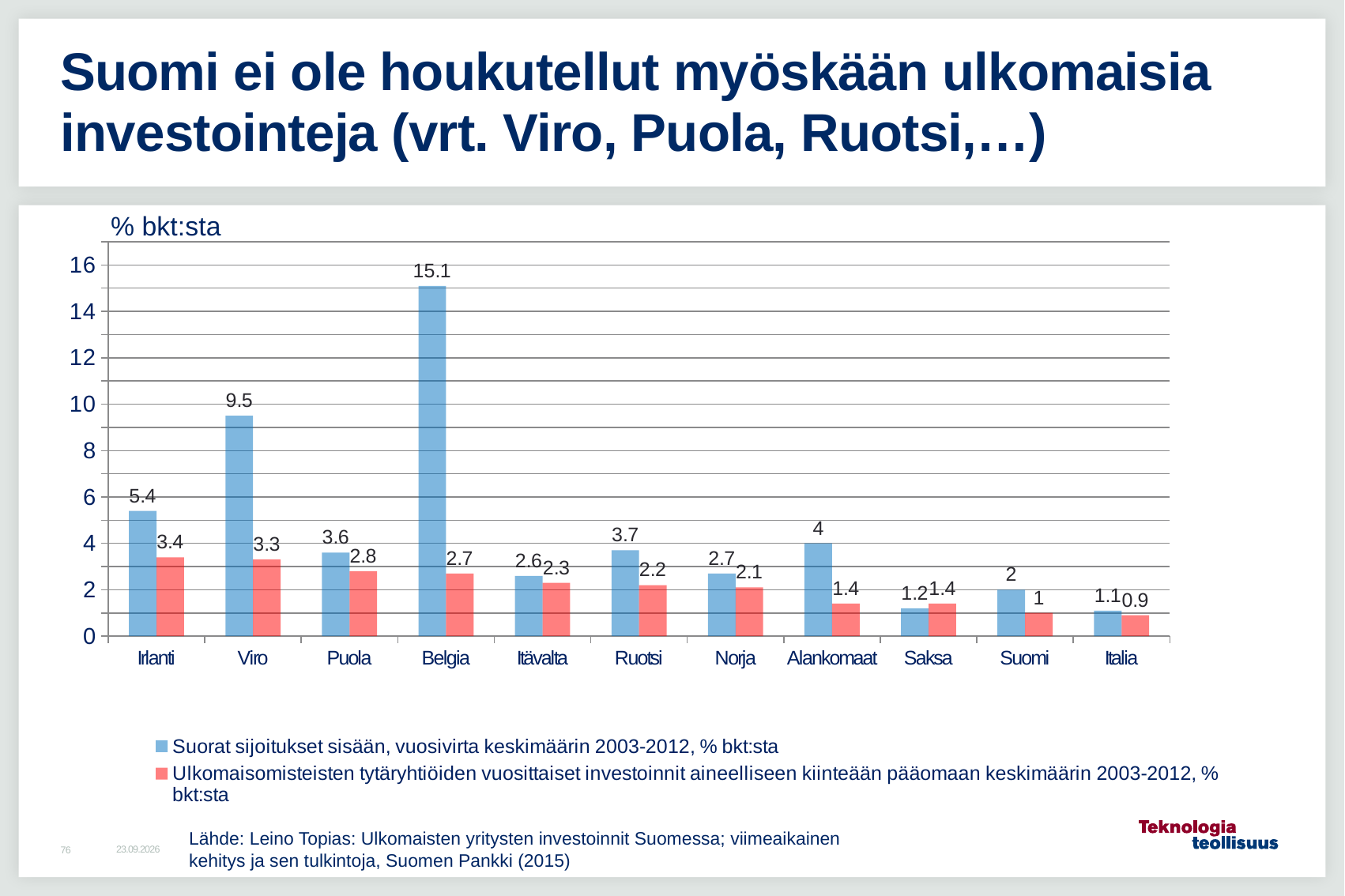
What is the value of the blue series (Suorat sijoitukset sisään) for Belgia? 15.1 Is the blue series value for Alankomaat greater or less than 2? greater Which is larger for Saksa: the blue series value or the red series value? the red series (1.4) What is the value of the red series (Ulkomaisomisteisten tytäryhtiöiden investoinnit) for Suomi? 1 How many series does the legend list? 2 How many countries are shown on the x axis? 11 What is the value of the blue series for Viro? 9.5 What kind of chart is shown on the slide? bar chart Which country has the lowest value in the red series? Italia What unit label is shown above the y axis? % bkt:sta What is the difference between the blue and red series values for Irlanti? 2 Which country has the highest value in the blue series? Belgia